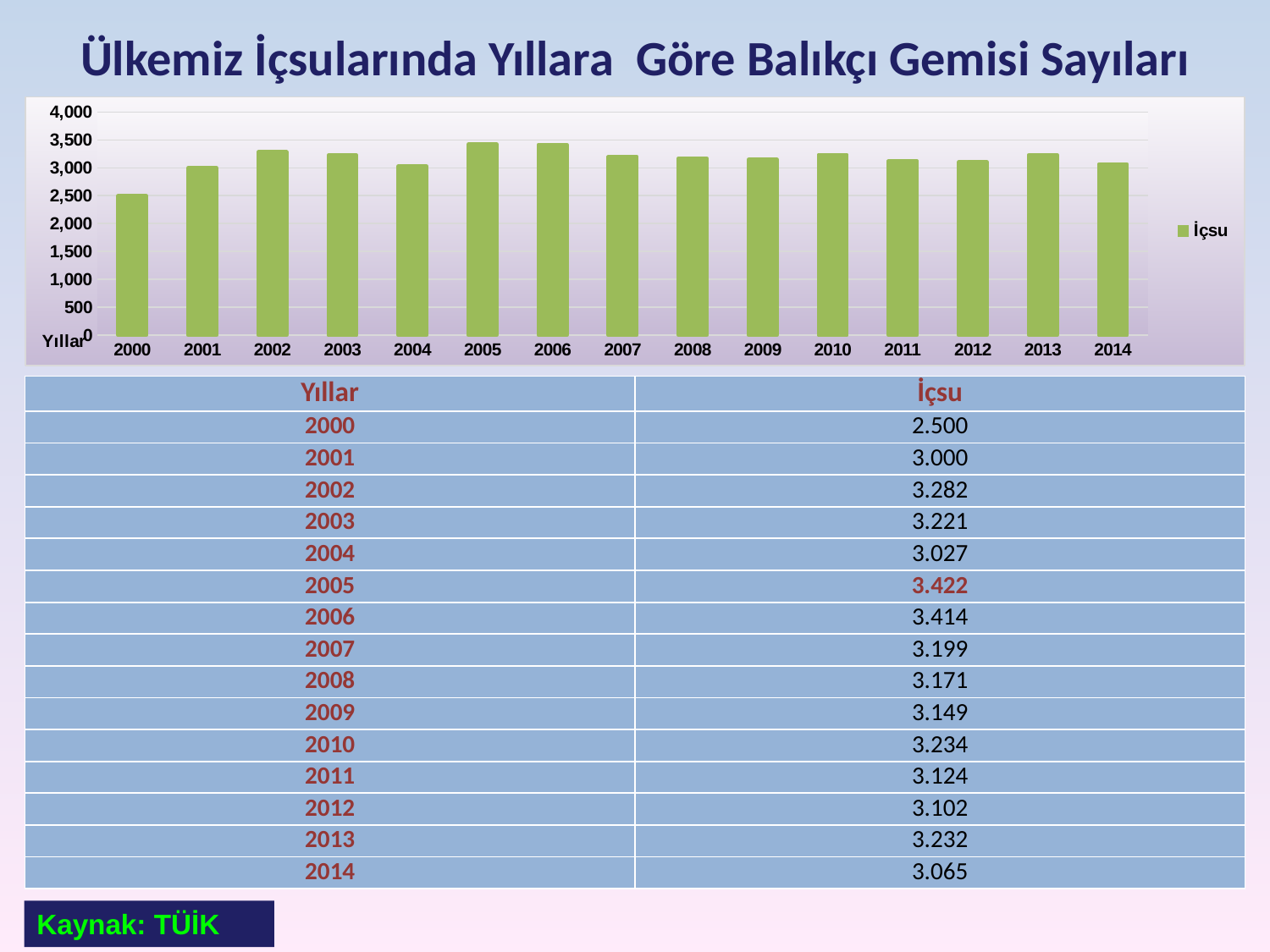
What is the difference between the İçsu values for 2001 and 2000? 500 How many years are shown on the x axis of the chart? 15 Which year has the highest İçsu value? 2005 What is the İçsu value for 2014? 3.065 Is the value for 2000 greater or less than 3,000? less What is the İçsu value for 2000? 2.500 How many series does the legend list? 1 Do the values rise or fall from 2000 to 2002? rise What is the İçsu value for 2005? 3.422 What kind of chart is shown on the slide? bar chart Which year has the lowest İçsu value? 2000 Which year has a larger İçsu value, 2002 or 2014? 2002